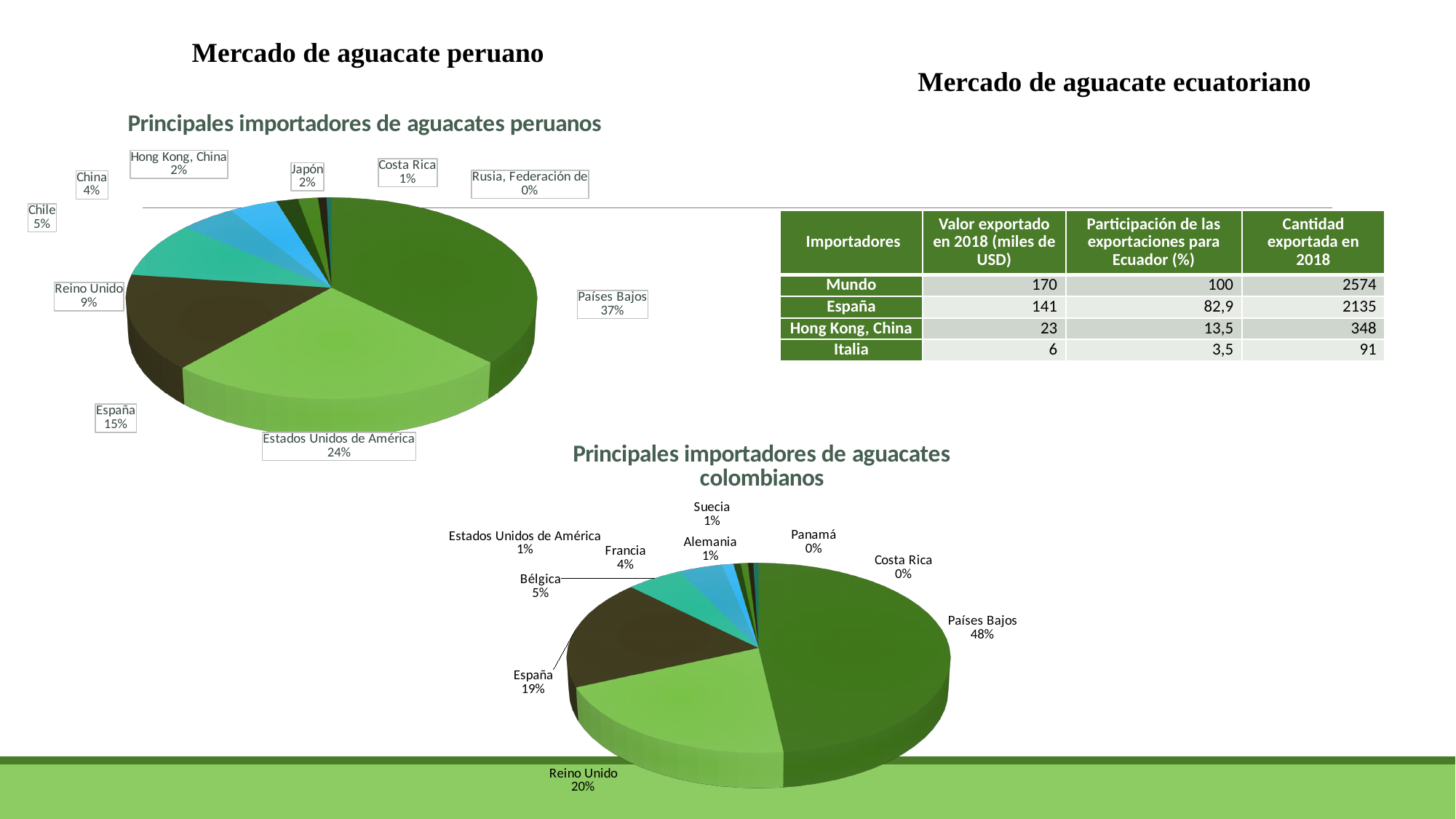
In the chart 'Principales importadores de aguacates colombianos', which is larger, the share of Reino Unido or the share of España? Reino Unido In the chart 'Principales importadores de aguacates colombianos', what share does Países Bajos have? 48% In the chart 'Principales importadores de aguacates colombianos', what share does Bélgica have? 5% In the chart 'Principales importadores de aguacates peruanos', which importer has the largest share? Países Bajos In the chart 'Principales importadores de aguacates peruanos', what share does Estados Unidos de América have? 24% In the chart 'Principales importadores de aguacates peruanos', how many importers are shown? 10 What type of chart is 'Principales importadores de aguacates peruanos'? Pie chart In the chart 'Principales importadores de aguacates colombianos', how many importers are shown? 10 In the chart 'Principales importadores de aguacates peruanos', which importer has the smallest share? Rusia, Federación de In the chart 'Principales importadores de aguacates peruanos', what is the difference between the shares of España and Reino Unido? 6% In the chart 'Principales importadores de aguacates peruanos', what share does Países Bajos have? 37% In the chart 'Principales importadores de aguacates colombianos', what is the difference between the shares of Países Bajos and Reino Unido? 28%